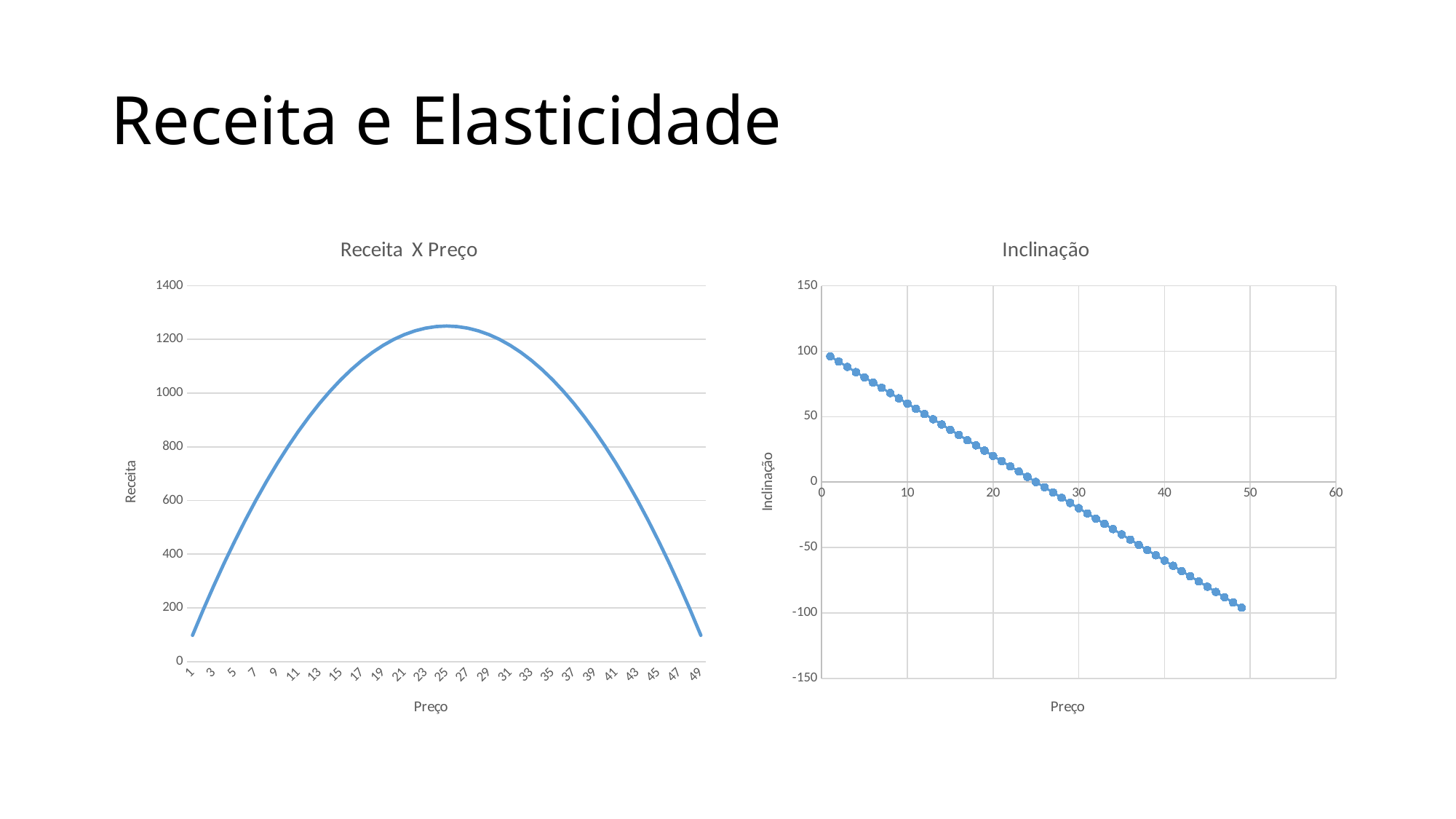
In the 'Inclinação' chart, do the values rise or fall as Preço increases? fall In the 'Receita X Preço' chart, is the value for Preço 1 greater or less than 200? less In the 'Inclinação' chart, is the value at Preço 40 greater or less than -50? less What is the label of the horizontal axis of the 'Inclinação' chart? Preço In the 'Inclinação' chart, is the value at Preço 10 greater or less than 50? greater In the 'Receita X Preço' chart, how does Receita change as Preço increases from 1 to 49? rises then falls What is the label of the vertical axis of the 'Receita X Preço' chart? Receita What type of chart is the 'Receita X Preço' chart? line chart What type of chart is the 'Inclinação' chart? scatter chart